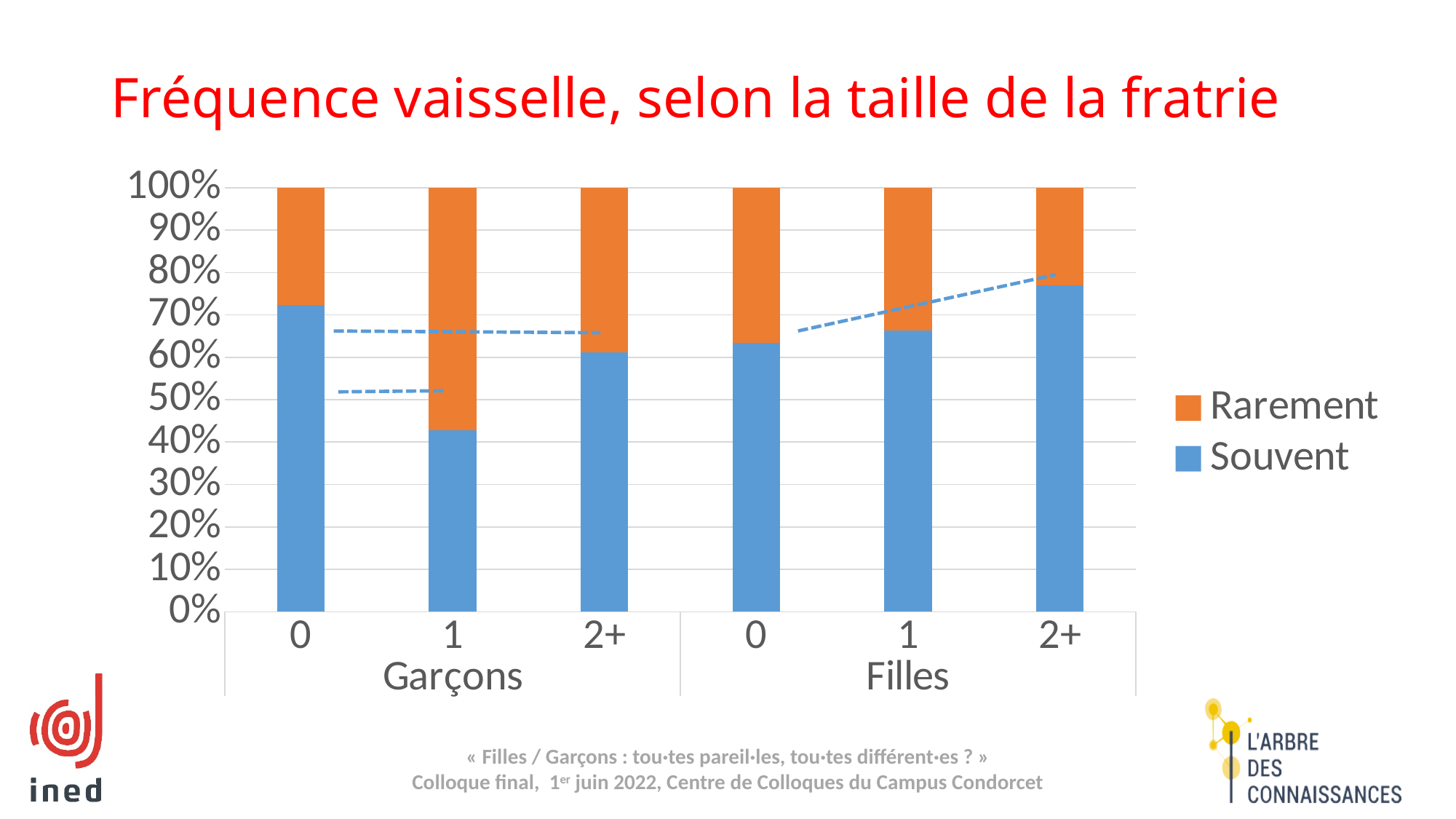
How many bars are plotted in the chart? 6 Which bar has the highest share of "Souvent"? Filles, 2+ Is the "Souvent" value for Filles with 0 siblings greater or less than 60%? greater How many series does the legend list? 2 Which colour represents "Rarement" in the chart? Orange Which has a larger "Souvent" share: Garçons with 0 siblings or Garçons with 1 sibling? Garçons with 0 siblings Is the "Souvent" value for Garçons with 1 sibling greater or less than 50%? less Is the "Souvent" value for Filles with 2+ siblings greater or less than 70%? greater What kind of chart is shown on the slide? Stacked bar chart Which has a larger "Souvent" share: Garçons with 1 sibling or Filles with 1 sibling? Filles with 1 sibling Which bar has the lowest share of "Souvent"? Garçons, 1